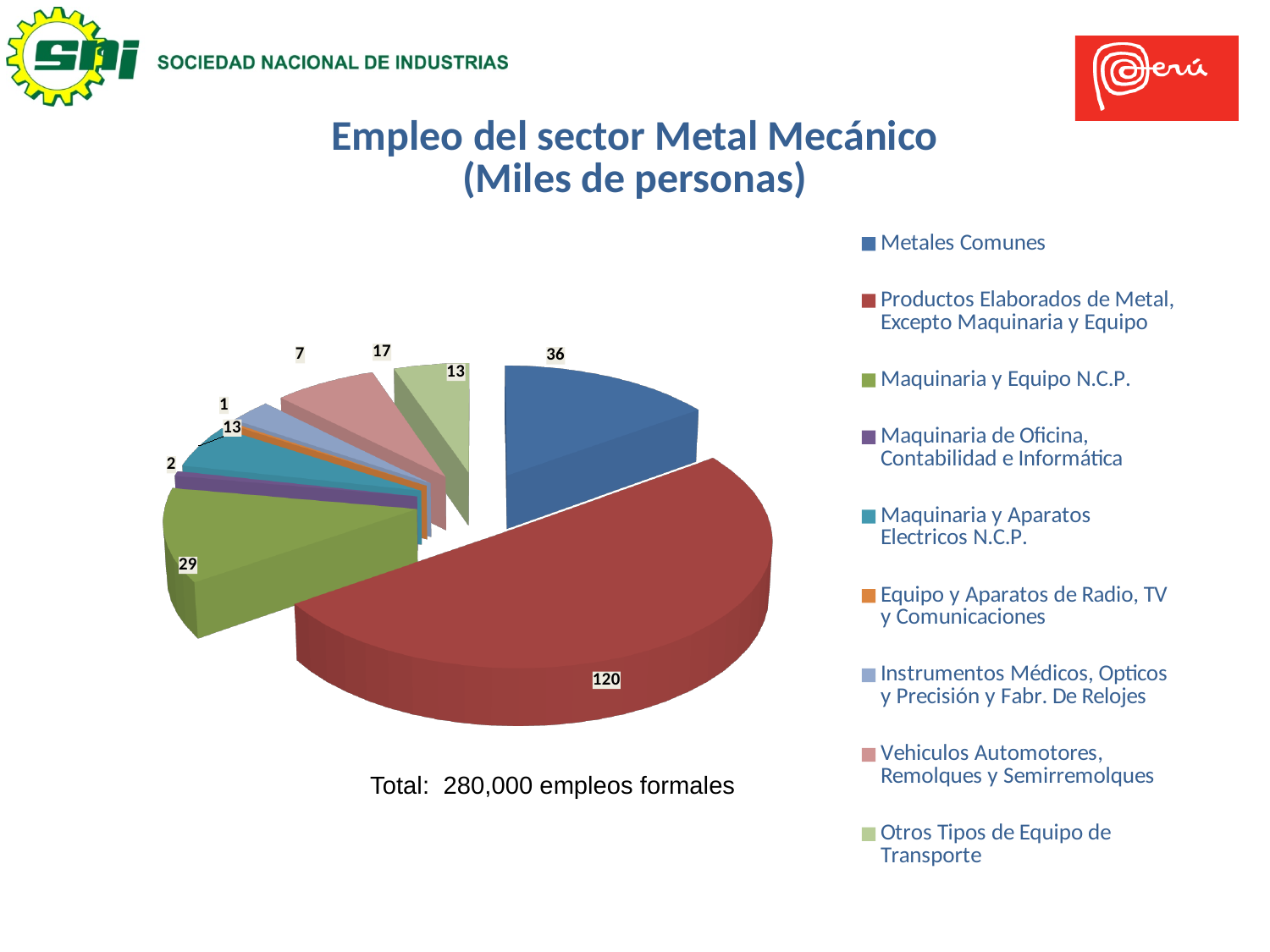
What is the value for Metales Comunes? 36 What is the value for Maquinaria de Oficina, Contabilidad e Informática? 2 What is the value for Maquinaria y Equipo N.C.P.? 29 How many categories does the pie chart show? 9 What is the title of the chart? Empleo del sector Metal Mecánico (Miles de personas) What is the value for Vehiculos Automotores, Remolques y Semirremolques? 17 What is the value for Productos Elaborados de Metal, Excepto Maquinaria y Equipo? 120 Which category has the smallest slice of the pie? Equipo y Aparatos de Radio, TV y Comunicaciones What is the difference between the values for Productos Elaborados de Metal, Excepto Maquinaria y Equipo and Metales Comunes? 84 Which category has the largest slice of the pie? Productos Elaborados de Metal, Excepto Maquinaria y Equipo What kind of chart is shown on the slide? Pie chart Which is larger, the value for Metales Comunes or the value for Maquinaria y Equipo N.C.P.? Metales Comunes